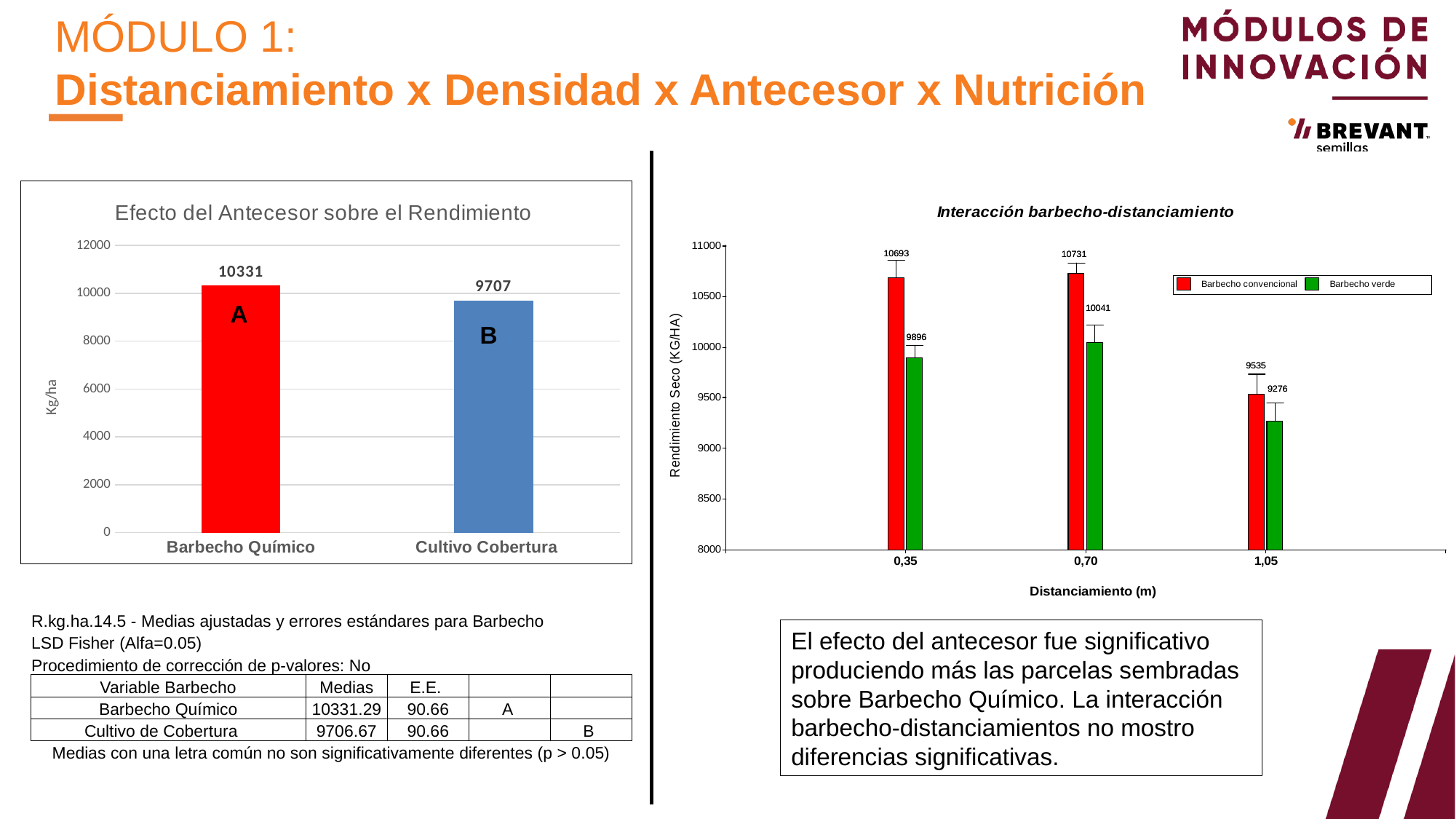
In the chart 'Efecto del Antecesor sobre el Rendimiento', which category has the higher value? Barbecho Químico In the chart 'Interacción barbecho-distanciamiento', how many distanciamiento categories are shown on the x axis? 3 What kind of chart is 'Efecto del Antecesor sobre el Rendimiento'? Bar chart In the chart 'Interacción barbecho-distanciamiento', how many series does the legend list? 2 In the chart 'Interacción barbecho-distanciamiento', what is the value for Barbecho convencional at 0,70 m? 10731 In the chart 'Efecto del Antecesor sobre el Rendimiento', what is the difference between Barbecho Químico and Cultivo Cobertura? 624 In the chart 'Interacción barbecho-distanciamiento', what colour are the Barbecho verde bars? Green In the chart 'Efecto del Antecesor sobre el Rendimiento', what is the value for Barbecho Químico? 10331 In the chart 'Interacción barbecho-distanciamiento', what is the difference between Barbecho convencional and Barbecho verde at 0,35 m? 797 In the chart 'Interacción barbecho-distanciamiento', which distanciamiento has the lowest value for Barbecho convencional? 1,05 In the chart 'Interacción barbecho-distanciamiento', what is the value for Barbecho verde at 1,05 m? 9276 In the chart 'Efecto del Antecesor sobre el Rendimiento', what is the value for Cultivo Cobertura? 9707